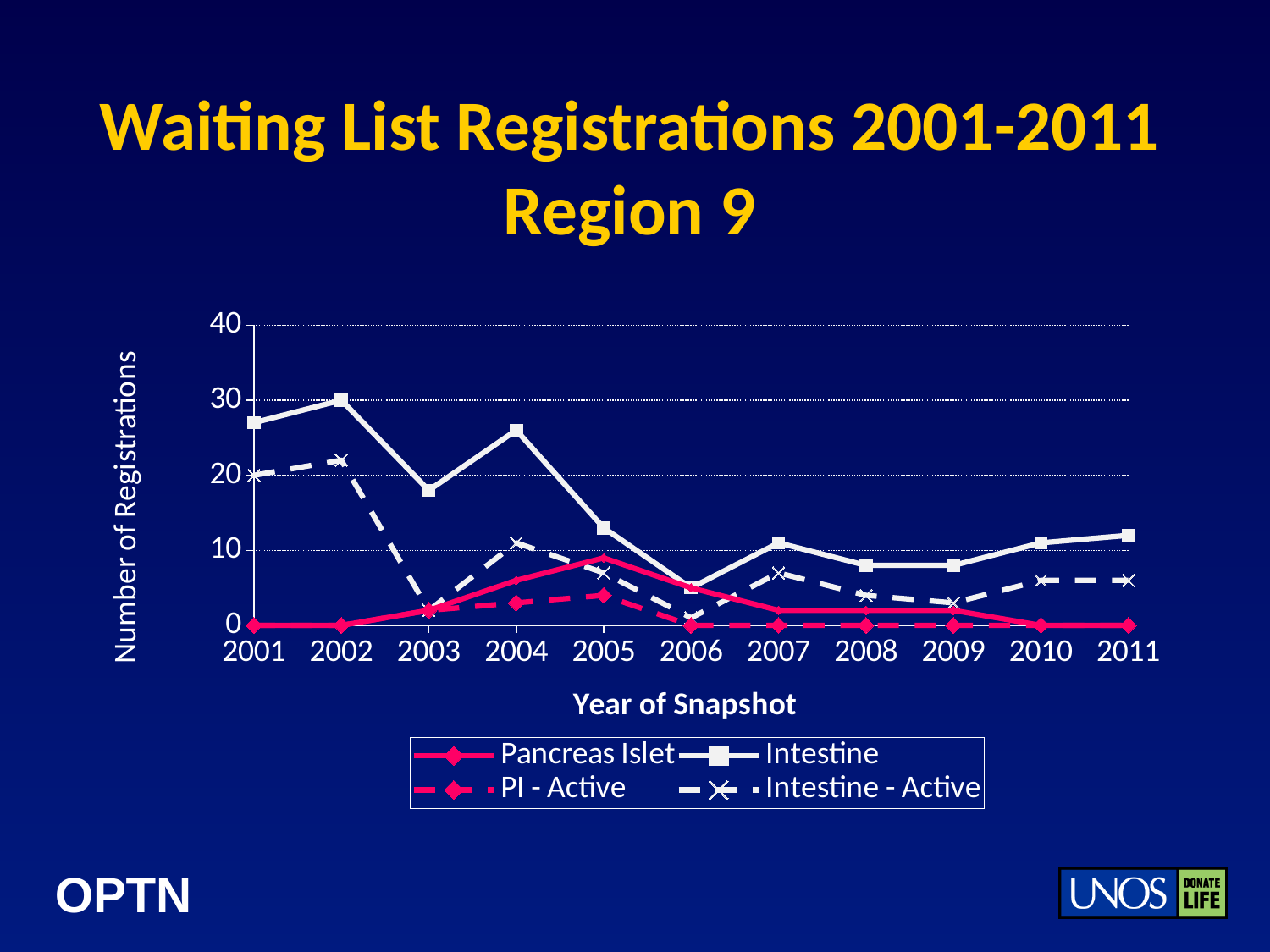
What is the value for Pancreas Islet in 2001? 0 Does the Intestine series rise or fall from 2002 to 2006? fall What kind of chart is shown on the slide? line chart What is the value for PI - Active in 2011? 0 How many years are plotted along the x axis? 11 In which year is the Intestine series at its lowest? 2006 How many series does the legend list? 4 Is the value for Intestine - Active in 2003 greater or less than 10? less Which is larger in 2004, Intestine or Pancreas Islet? Intestine Is the value for Intestine in 2001 greater or less than 20? greater Is the value for Intestine in 2003 greater or less than 20? less In which year is the Intestine series at its highest? 2002